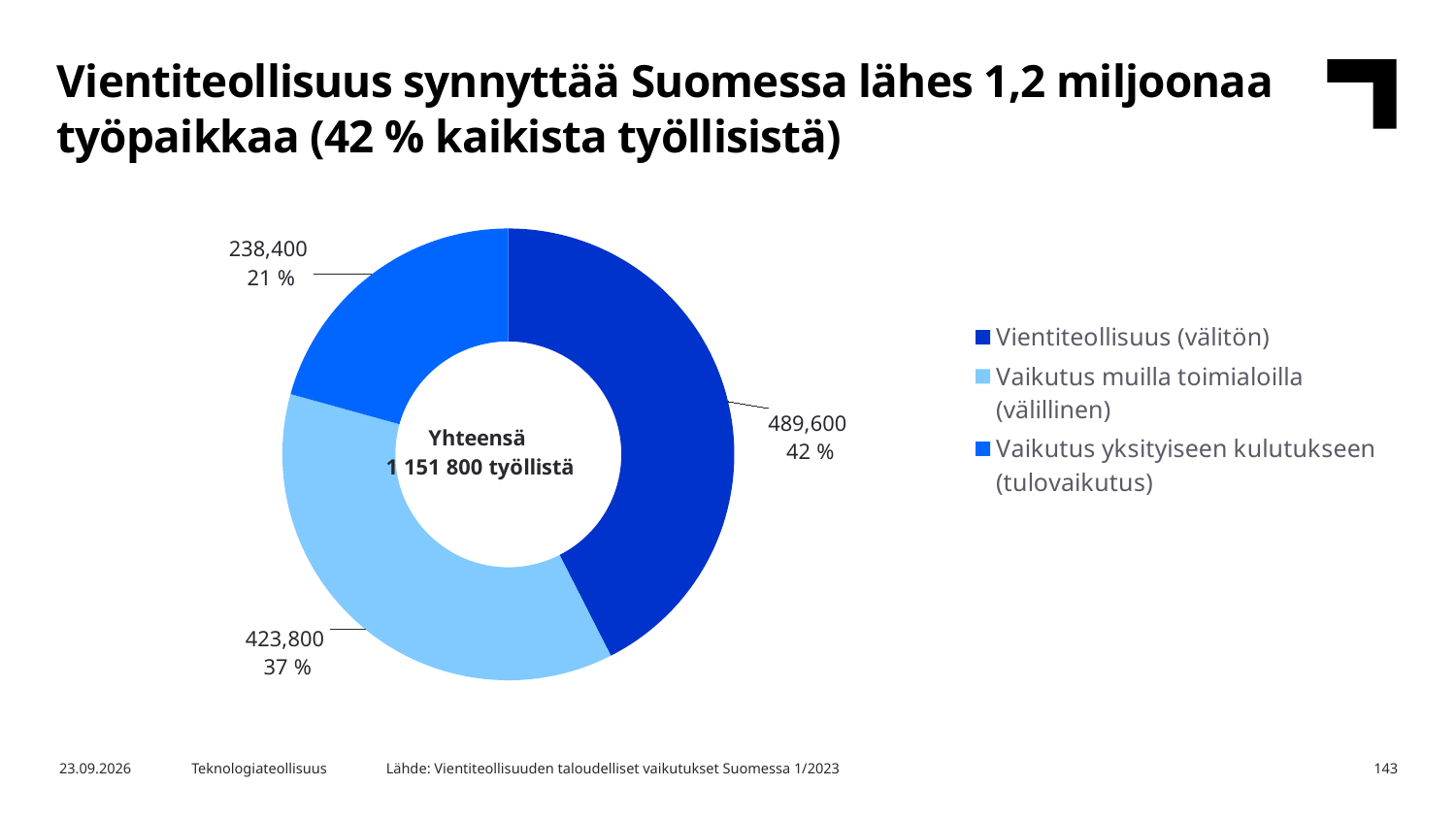
What is the difference between the values for Vientiteollisuus (välitön) and Vaikutus muilla toimialoilla (välillinen)? 65,800 What kind of chart is shown on the slide? Doughnut (pie) chart What share of the doughnut does Vaikutus yksityiseen kulutukseen (tulovaikutus) represent? 21 % What is the value for Vaikutus muilla toimialoilla (välillinen)? 423,800 How many slices does the doughnut chart have? 3 What is the value for Vaikutus yksityiseen kulutukseen (tulovaikutus)? 238,400 Which category has the smallest slice? Vaikutus yksityiseen kulutukseen (tulovaikutus) How many entries does the legend list? 3 Which category has the largest slice? Vientiteollisuus (välitön) What is the value for Vientiteollisuus (välitön)? 489,600 What share of the doughnut does Vientiteollisuus (välitön) represent? 42 % What total is shown in the centre of the doughnut chart? 1 151 800 työllistä